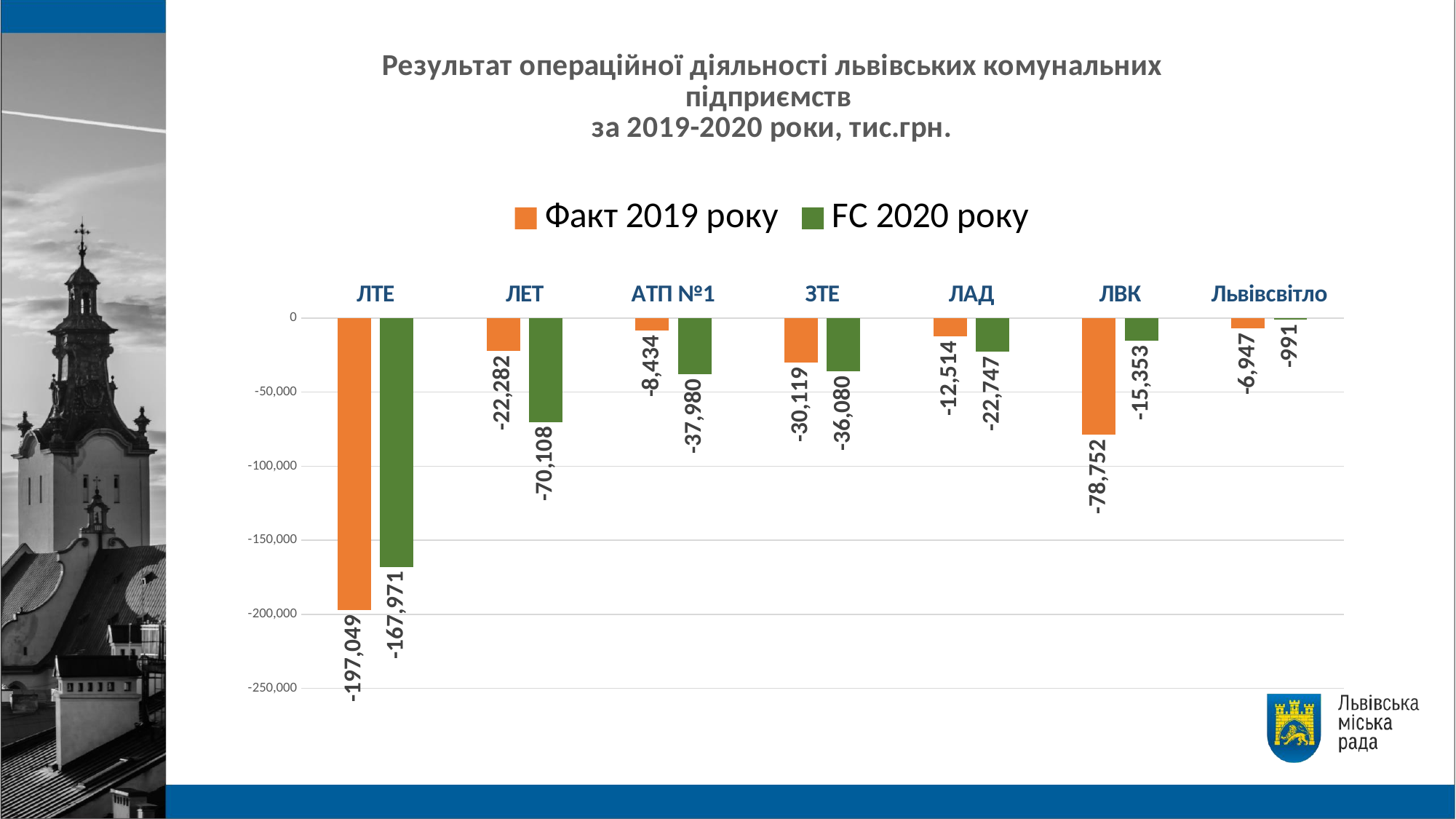
What kind of chart is shown on the slide? Bar chart What is the FC 2020 року value for Львівсвітло? -991 How many series does the legend list? 2 What is the Факт 2019 року value for ЛВК? -78,752 What is the Факт 2019 року value for ЛТЕ? -197,049 What is the difference between the Факт 2019 року and FC 2020 року values for ЛВК? 63,399 What is the FC 2020 року value for ЛЕТ? -70,108 What is the difference between the Факт 2019 року and FC 2020 року values for ЛТЕ? 29,078 How many categories are shown on the x axis? 7 Which category has the highest (closest to zero) FC 2020 року value? Львівсвітло Which category has the lowest (most negative) Факт 2019 року value? ЛТЕ For ЛЕТ, which series has the lower (more negative) value: Факт 2019 року or FC 2020 року? FC 2020 року